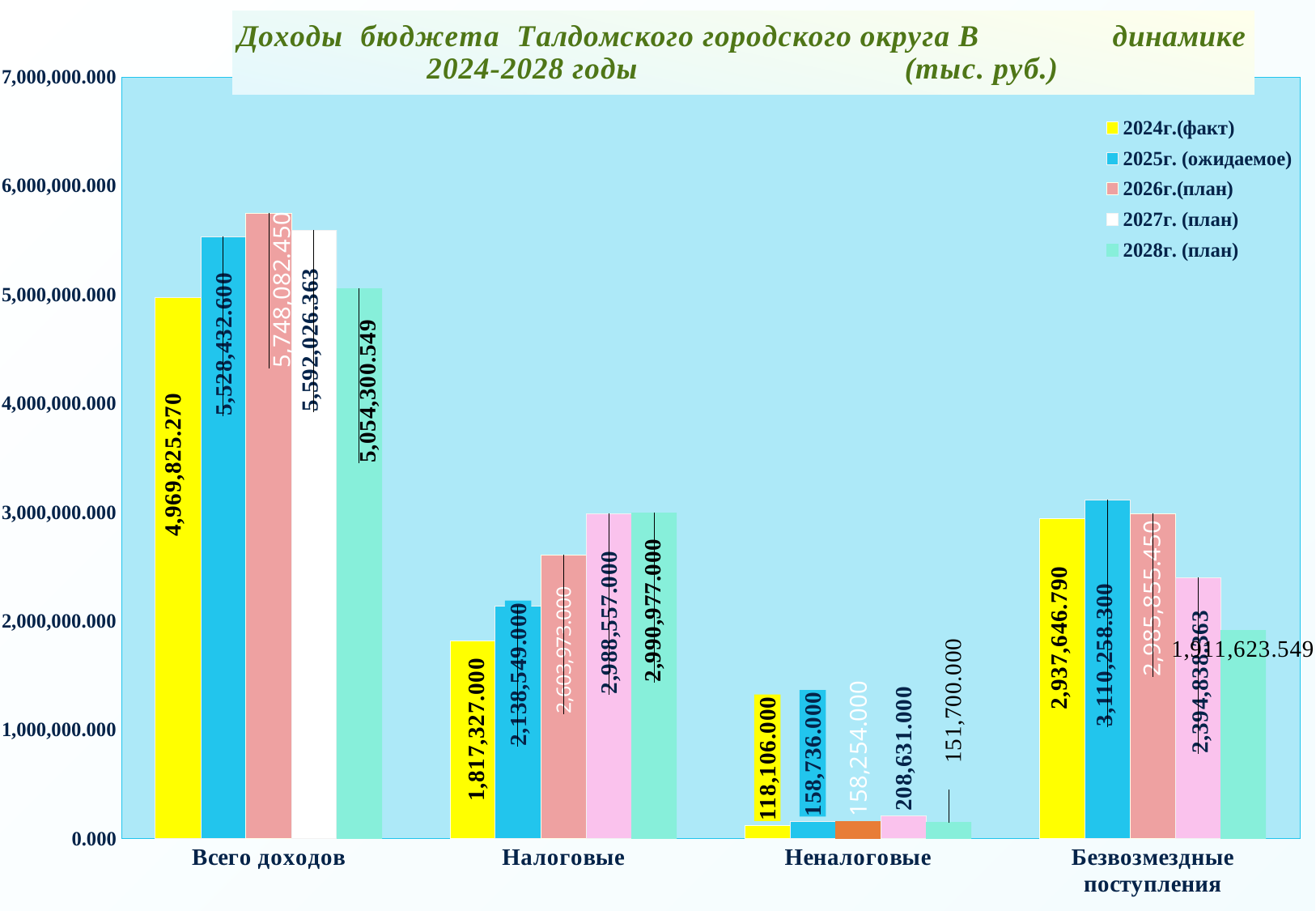
Which year has the highest value in the Всего доходов category? 2026г.(план) In the Налоговые category, do the values rise or fall from 2024 to 2028? Rise What kind of chart is shown on the slide? Bar chart Which year has the lowest value in the Неналоговые category? 2024г.(факт) What is the value for 2027г. (план) in the Налоговые category? 2,988,557.000 In the Безвозмездные поступления category, which is larger: the 2025г. (ожидаемое) value or the 2026г.(план) value? 2025г. (ожидаемое) What is the value for 2028г. (план) in the Безвозмездные поступления category? 1,911,623.549 What is the difference between the 2025г. (ожидаемое) and 2024г.(факт) values in the Всего доходов category? 558,607.330 How many categories are shown on the x axis? 4 How many series does the legend list? 5 What is the value for 2024г.(факт) in the Всего доходов category? 4,969,825.270 Which legend entry is shown in yellow? 2024г.(факт)